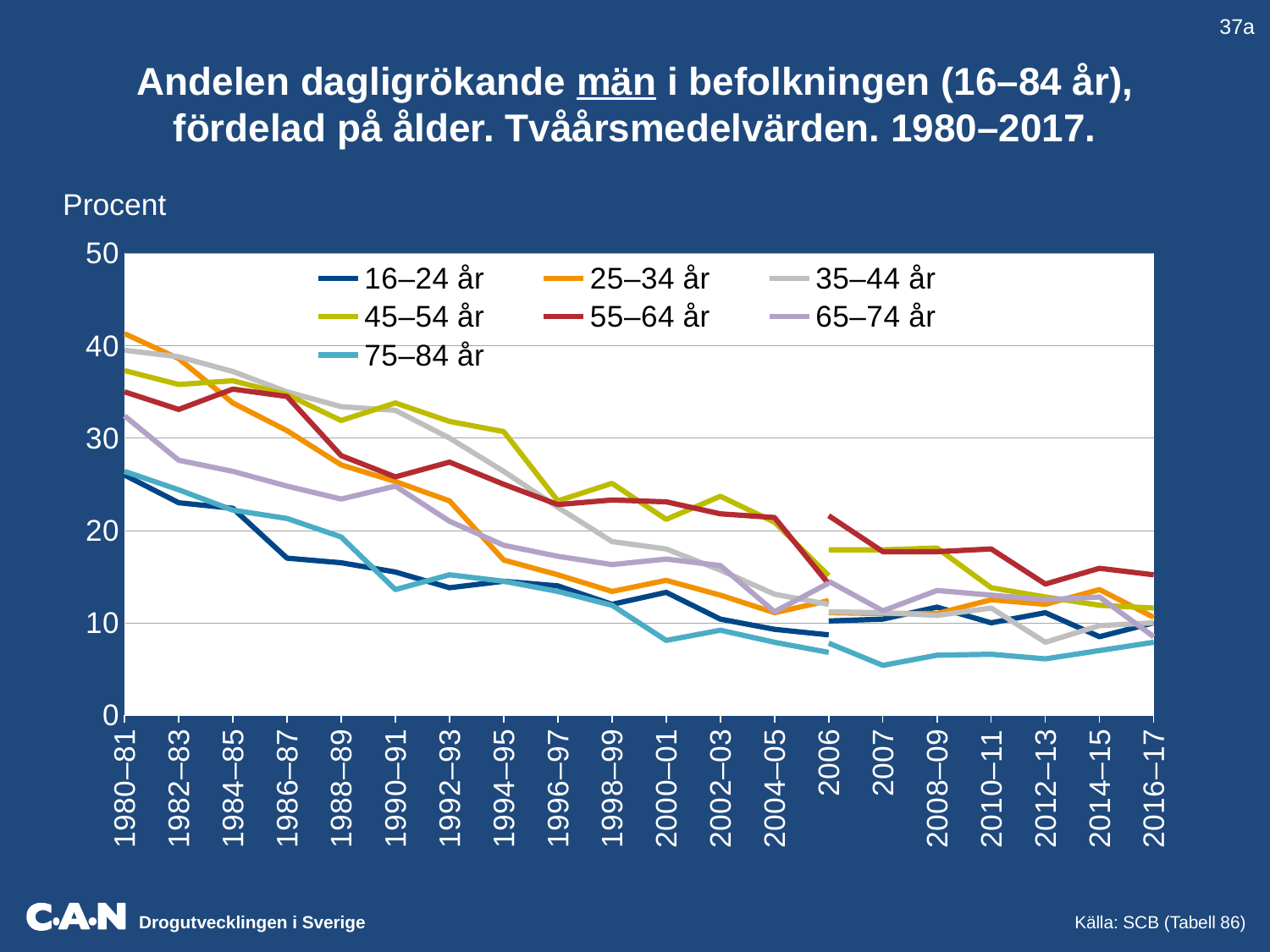
What kind of chart is shown on the slide? Line chart Which is larger at 1994–95, the value for 45–54 år or the value for 16–24 år? 45–54 år Which age group has the highest value at 1980–81? 25–34 år Which age group has the lowest value at 2006? 75–84 år Which age group has the highest value at 2016–17? 55–64 år How many categories are labelled on the x axis? 20 Is the value for 25–34 år at 1980–81 greater or less than 40? greater Do the values for 35–44 år generally rise or fall from 1980–81 to 2016–17? fall What unit label is shown above the y axis? Procent Is the value for 75–84 år at 2007 greater or less than 10? less How many series does the legend list? 7